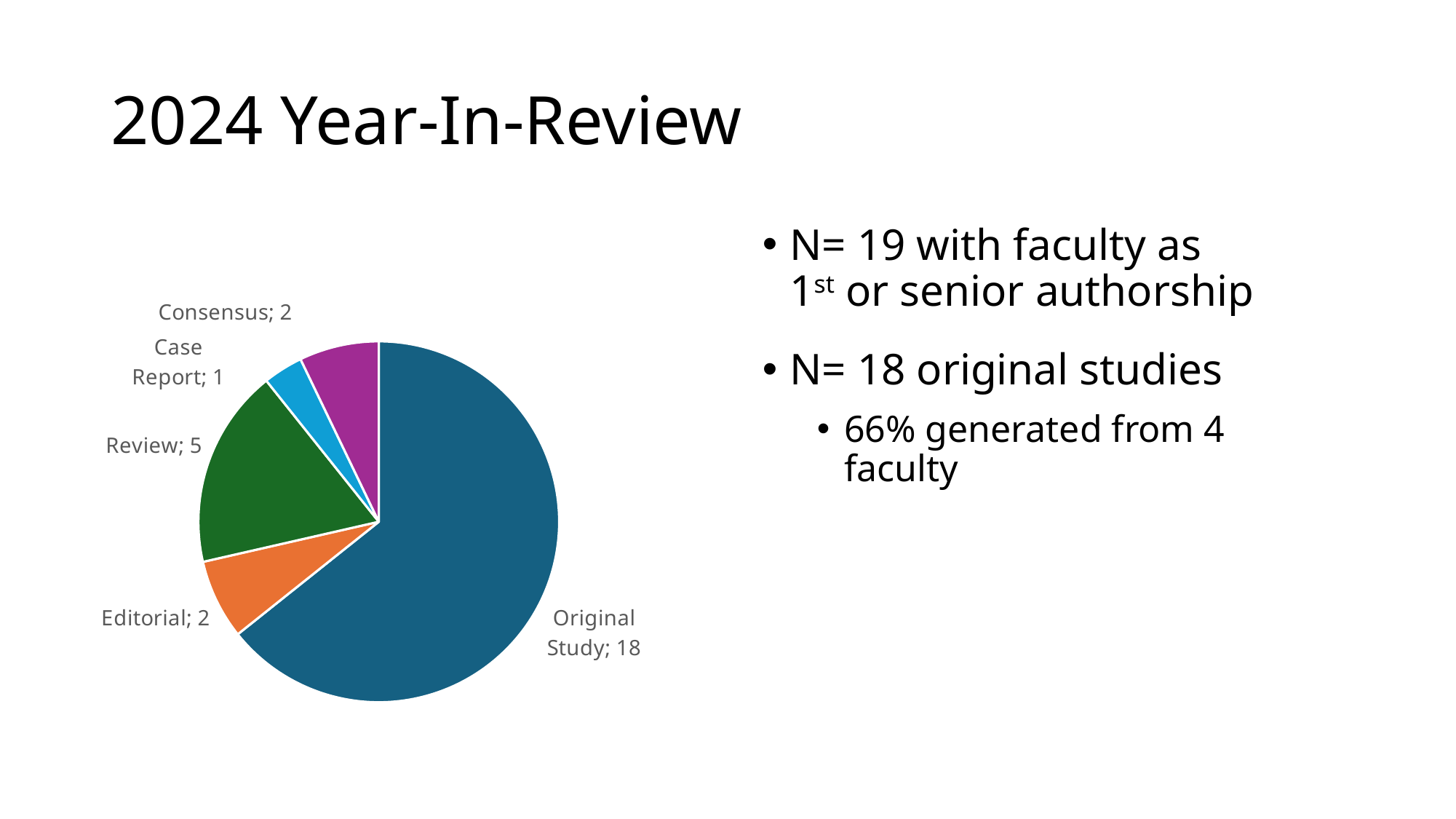
Which is larger in the pie chart, Review or Editorial? Review What is the total of all slices in the pie chart? 28 What is the value for Original Study in the pie chart? 18 What type of chart is shown on the slide? Pie chart Which category has the largest slice in the pie chart? Original Study What is the value for Case Report in the pie chart? 1 What is the value for Consensus in the pie chart? 2 How many slices does the pie chart have? 5 Which category has the smallest slice in the pie chart? Case Report What is the difference between the Original Study value and the Review value? 13 What is the value for Review in the pie chart? 5 What share of the pie does the Original Study slice represent? 64.3%